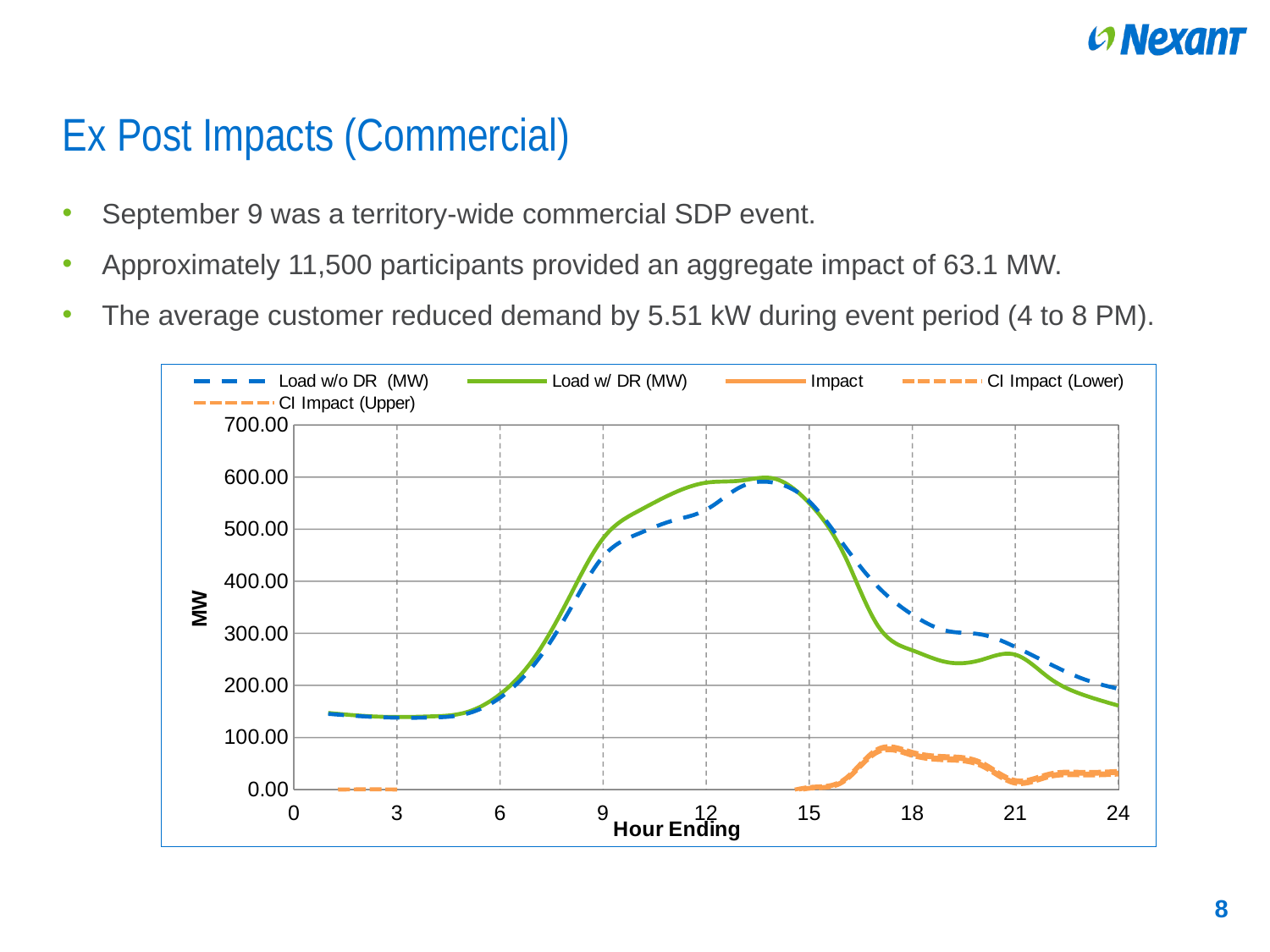
What is the title of the chart's y axis? MW Is the value of Load w/o DR (MW) at hour ending 18 greater or less than 200.00? greater Is the value of Load w/ DR (MW) at hour ending 12 greater or less than 500.00? greater Is the value of Impact at hour ending 17 greater or less than 100.00? less At hour ending 18, which series is higher: Load w/o DR (MW) or Load w/ DR (MW)? Load w/o DR (MW) Does the Load w/ DR (MW) series rise or fall between hour ending 14 and hour ending 18? fall Does the Load w/o DR (MW) series rise or fall between hour ending 6 and hour ending 12? rise What is the title of the chart's x axis? Hour Ending How many series does the chart legend list? 5 What kind of chart is shown on the slide? line chart